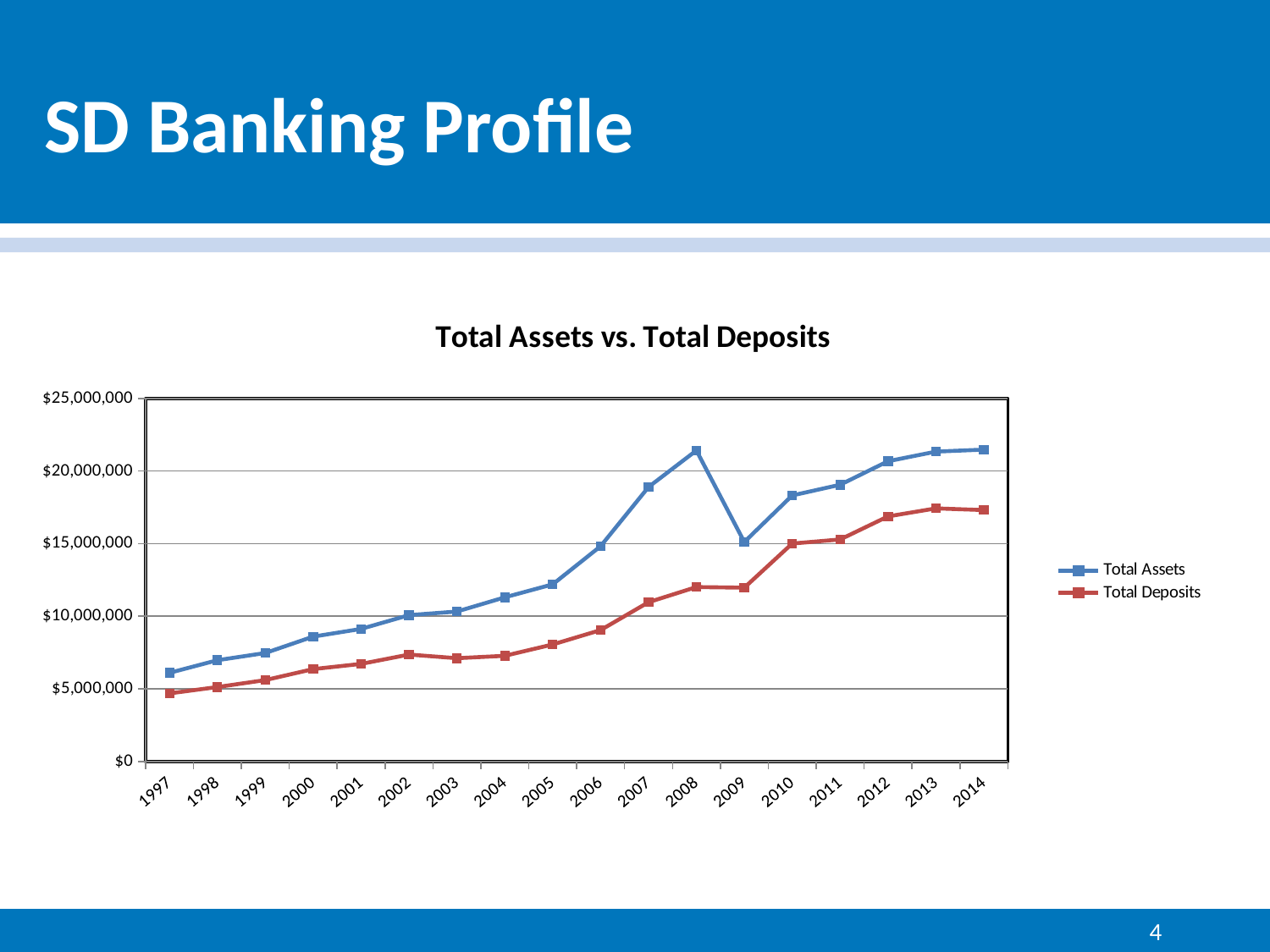
What kind of chart is shown on the slide? line chart Is the value for Total Assets in 2008 greater or less than $20,000,000? greater In 2008, which is larger: Total Assets or Total Deposits? Total Assets Which series is drawn in red? Total Deposits In which year is Total Assets at its lowest? 1997 How many series does the legend list? 2 Is the value for Total Assets in 1997 greater or less than $5,000,000? greater Is the value for Total Deposits in 2014 greater or less than $15,000,000? greater In which year is Total Deposits at its lowest? 1997 Does Total Assets rise or fall from 2008 to 2009? fall How many years are plotted along the x axis? 18 What is the title of the chart? Total Assets vs. Total Deposits